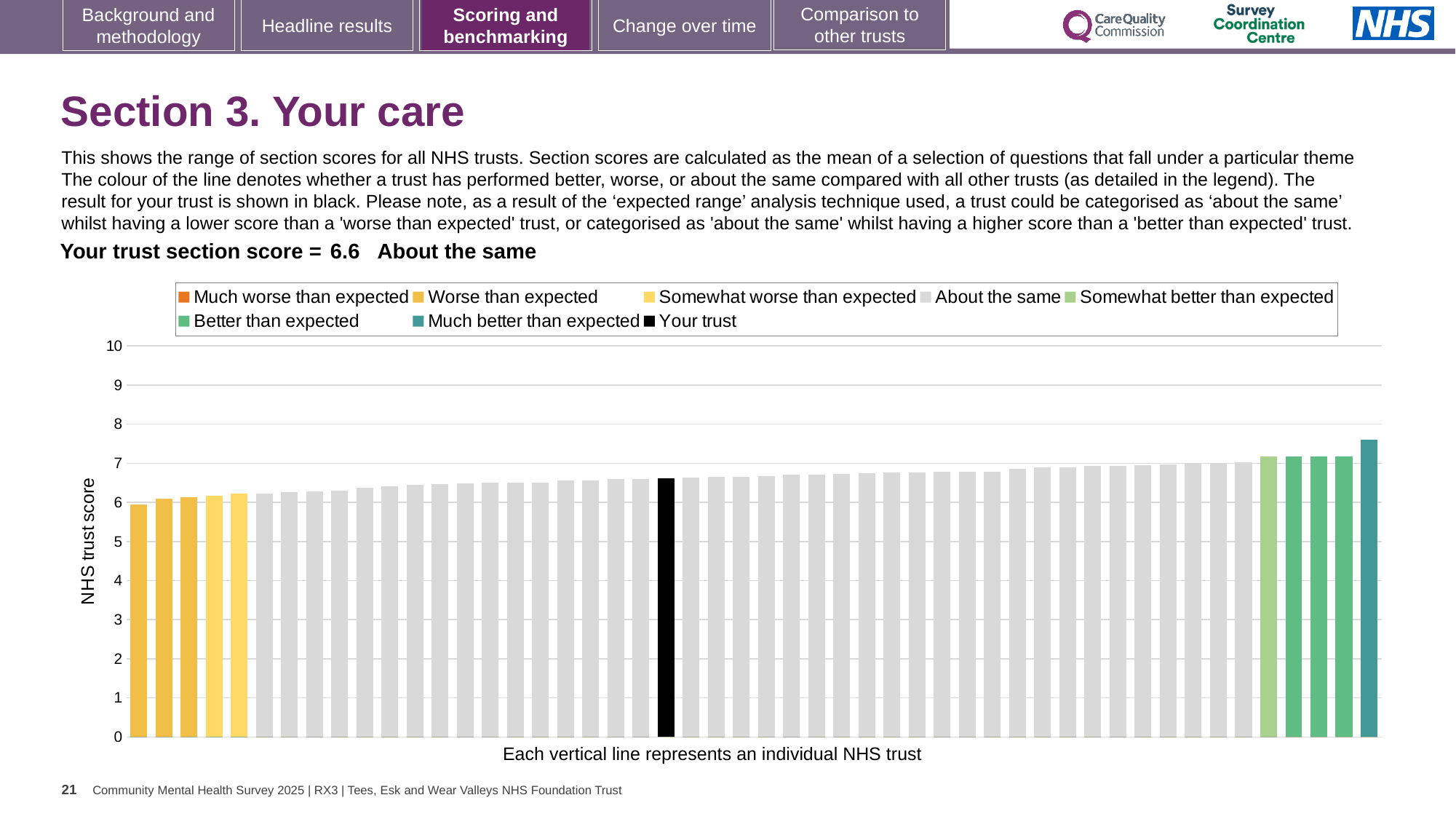
How many entries does the chart legend list? 8 What kind of chart is shown on the slide? bar chart Is the value of the black 'Your trust' bar greater or less than 6? greater Which category is your trust placed in for this section? About the same Which legend category does the tallest bar belong to? Much better than expected Do the bar values rise or fall from left to right along the x axis? rise What is the section score for your trust shown on the slide? 6.6 What colour is the bar representing your trust? black What is the label on the y axis of the chart? NHS trust score Is the value of the tallest bar greater or less than 7? greater How many bars are coloured as 'Much better than expected'? 1 Is the value of the shortest bar greater or less than 7? less